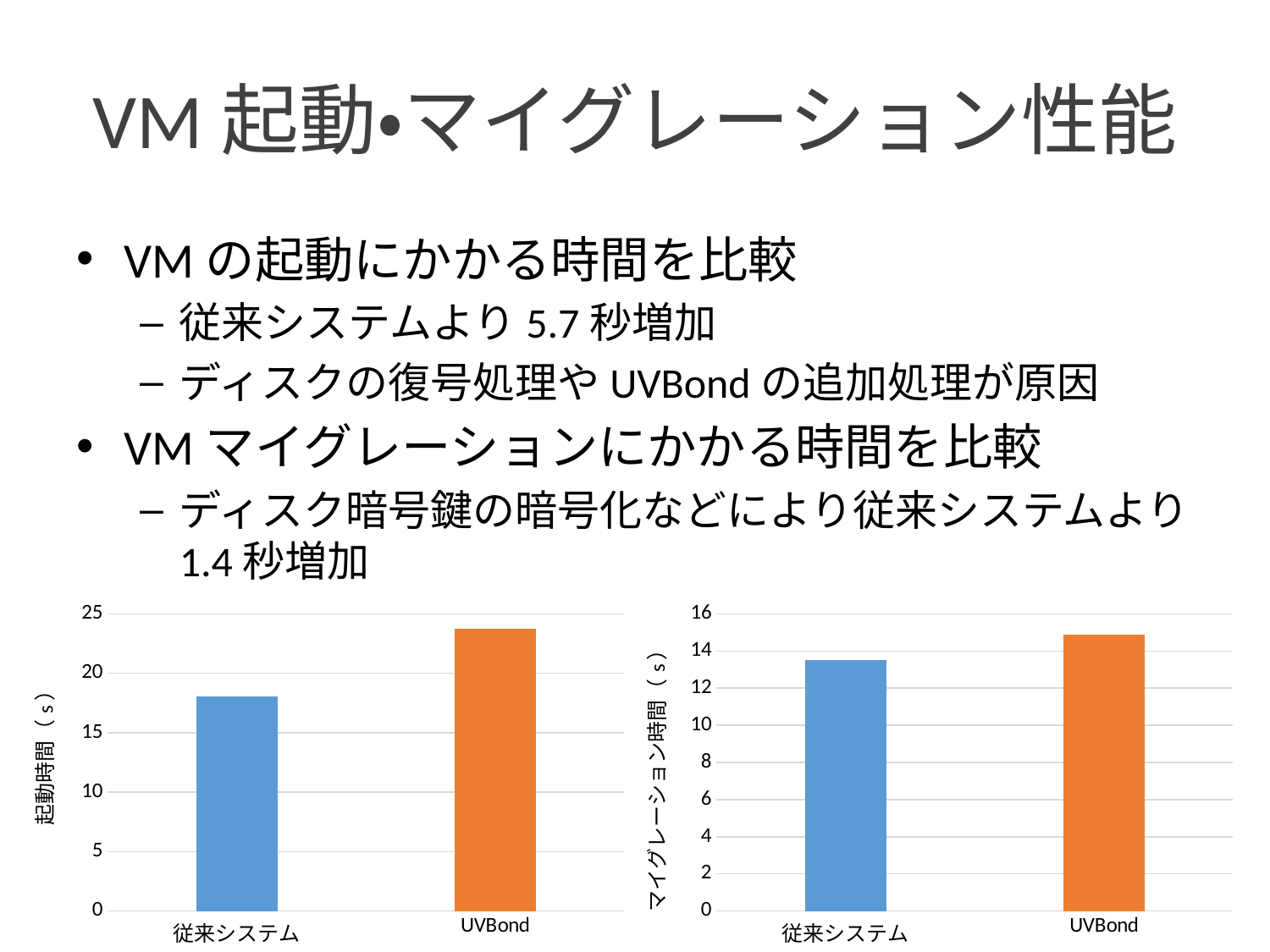
In the right chart (マイグレーション時間), is the value for 従来システム greater or less than 12? greater In the left chart (起動時間), is the value for 従来システム greater or less than 15? greater In the right chart (マイグレーション時間), is the value for UVBond greater or less than 14? greater In the right chart (マイグレーション時間), which category has the higher bar? UVBond What is the y-axis label of the left chart? 起動時間（s） In the left chart (起動時間), which category has the higher bar? UVBond How many categories are shown in the left chart (起動時間)? 2 What kind of chart is the right chart (マイグレーション時間)? bar chart In the left chart (起動時間), which category has the lower bar? 従来システム